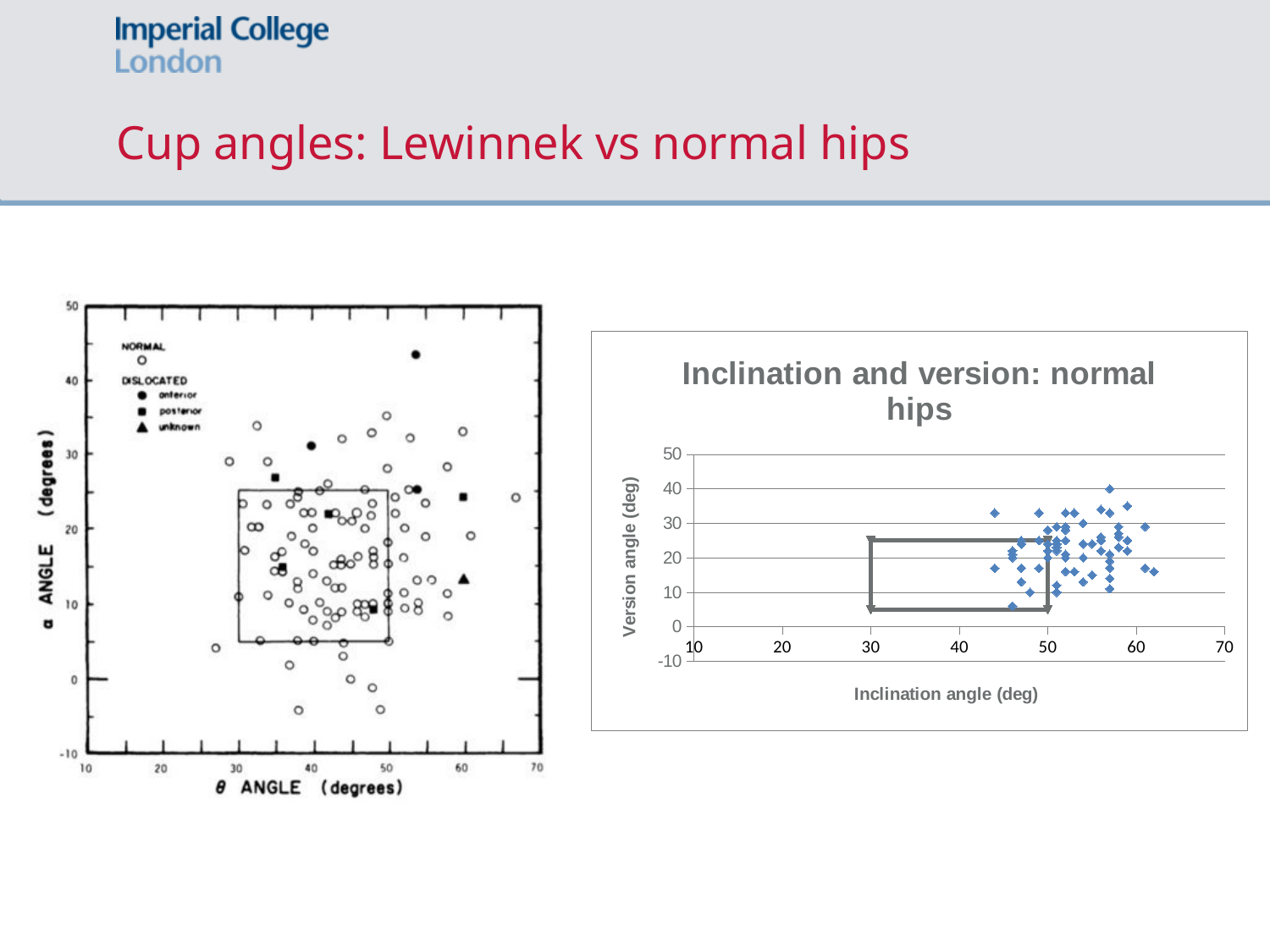
How many marker types does the legend of the left-hand chart list in total? 4 On the right-hand chart, is the lowest inclination angle plotted greater or less than 40? greater What kind of chart is the right-hand chart titled 'Inclination and version: normal hips'? scatter chart What is the title of the right-hand chart? Inclination and version: normal hips On the right-hand chart, what is the highest value shown on the version angle axis? 50 What kind of chart is the left-hand chart with the θ ANGLE axis? scatter chart On the right-hand chart, is the highest version angle plotted greater or less than 30? greater On the left-hand chart, what marker types does the legend list under DISLOCATED? anterior, posterior, unknown On the right-hand chart, between which two inclination angle tick values does the drawn rectangle extend? 30 and 50 On the left-hand chart, is the lowest α ANGLE plotted greater or less than 0? less